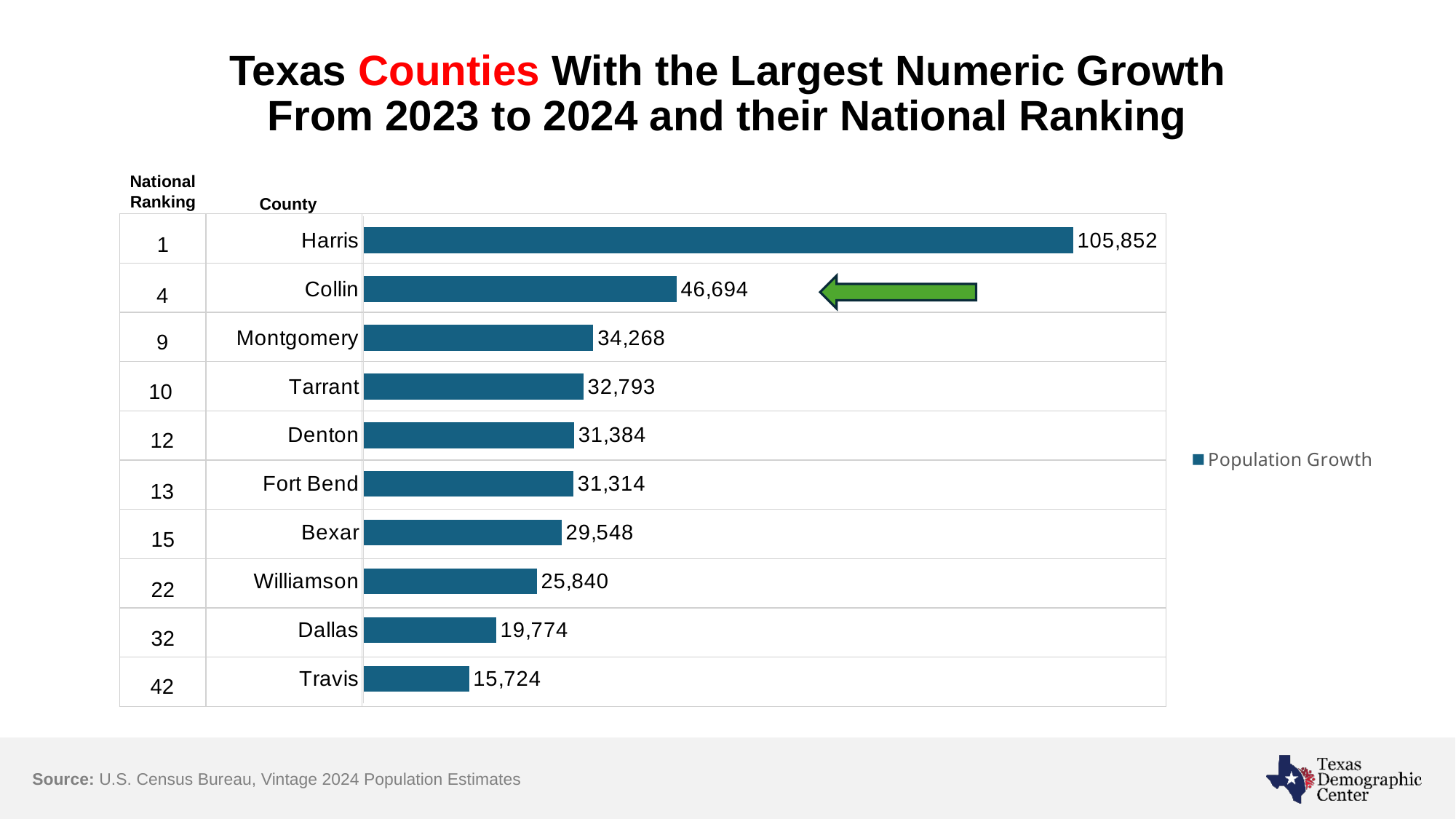
Which county has the highest population growth? Harris How many counties are shown in the chart? 10 Which county has a larger population growth, Williamson or Dallas? Williamson Which county has the lowest population growth? Travis Which county has a larger population growth, Montgomery or Bexar? Montgomery What is the population growth value for Travis County? 15,724 What is the population growth value for Harris County? 105,852 What is the population growth value for Collin County? 46,694 What is the difference in population growth between Dallas and Travis? 4,050 What is the national ranking of Tarrant County? 10 What type of chart is shown on the slide? Bar chart What is the difference in population growth between Harris and Collin? 59,158